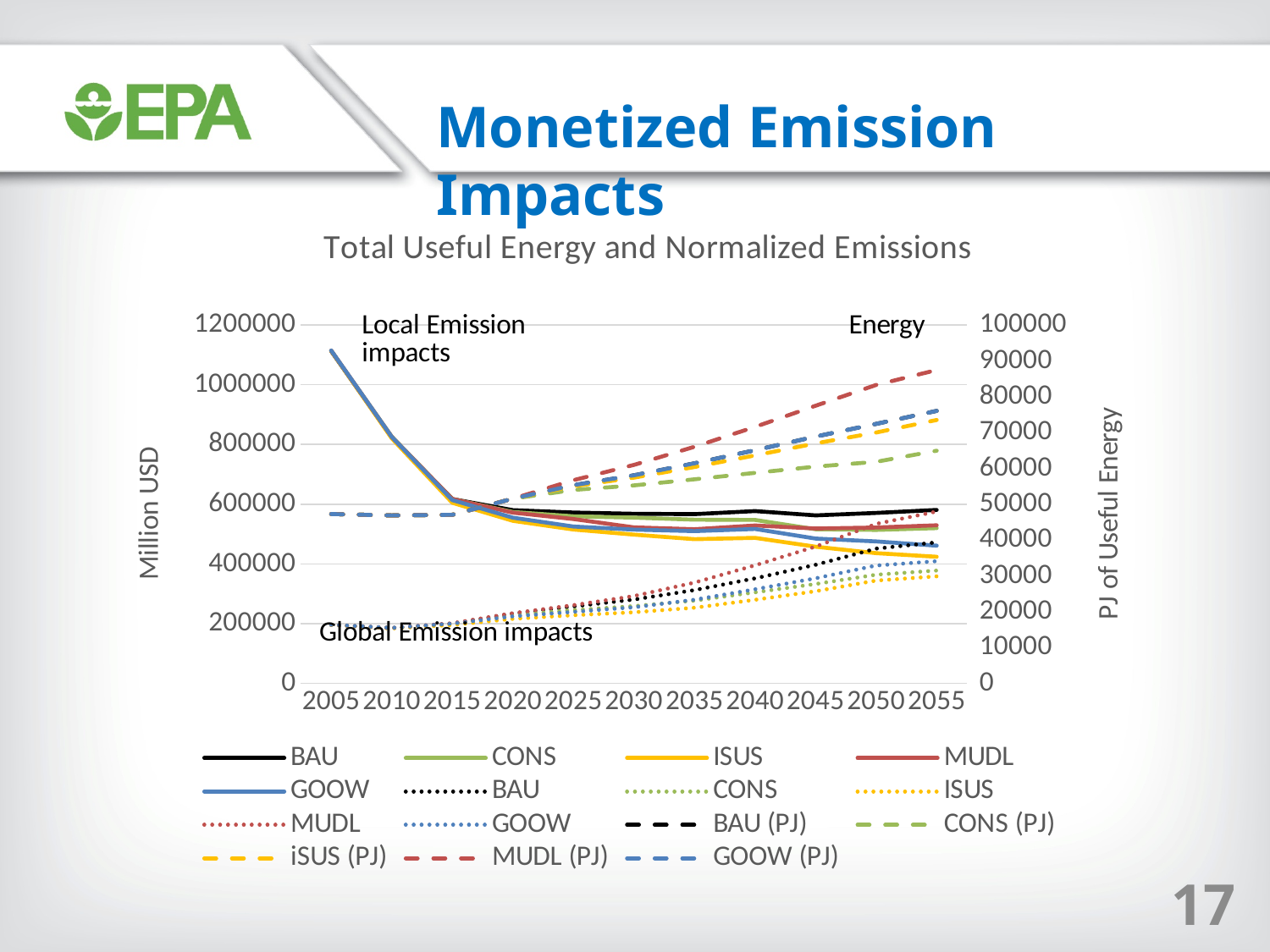
What is the title of the chart? Total Useful Energy and Normalized Emissions Which Energy (PJ) series is highest in 2055? MUDL (PJ) In 2055, which is larger among the solid Local Emission impacts lines: BAU or ISUS? BAU Which Energy (PJ) series is lowest in 2055? CONS (PJ) How many series does the legend list? 15 How many years are marked along the x axis? 11 What is the label of the left vertical axis? Million USD What kind of chart is shown on the slide? line chart Do the solid Local Emission impacts lines rise or fall from 2005 to 2055? fall Do the dotted Global Emission impacts lines rise or fall from 2005 to 2055? rise Is the value of the solid Local Emission impacts lines in 2005 greater or less than 1000000 Million USD? greater Do the dashed Energy (PJ) lines rise or fall from 2015 to 2055? rise